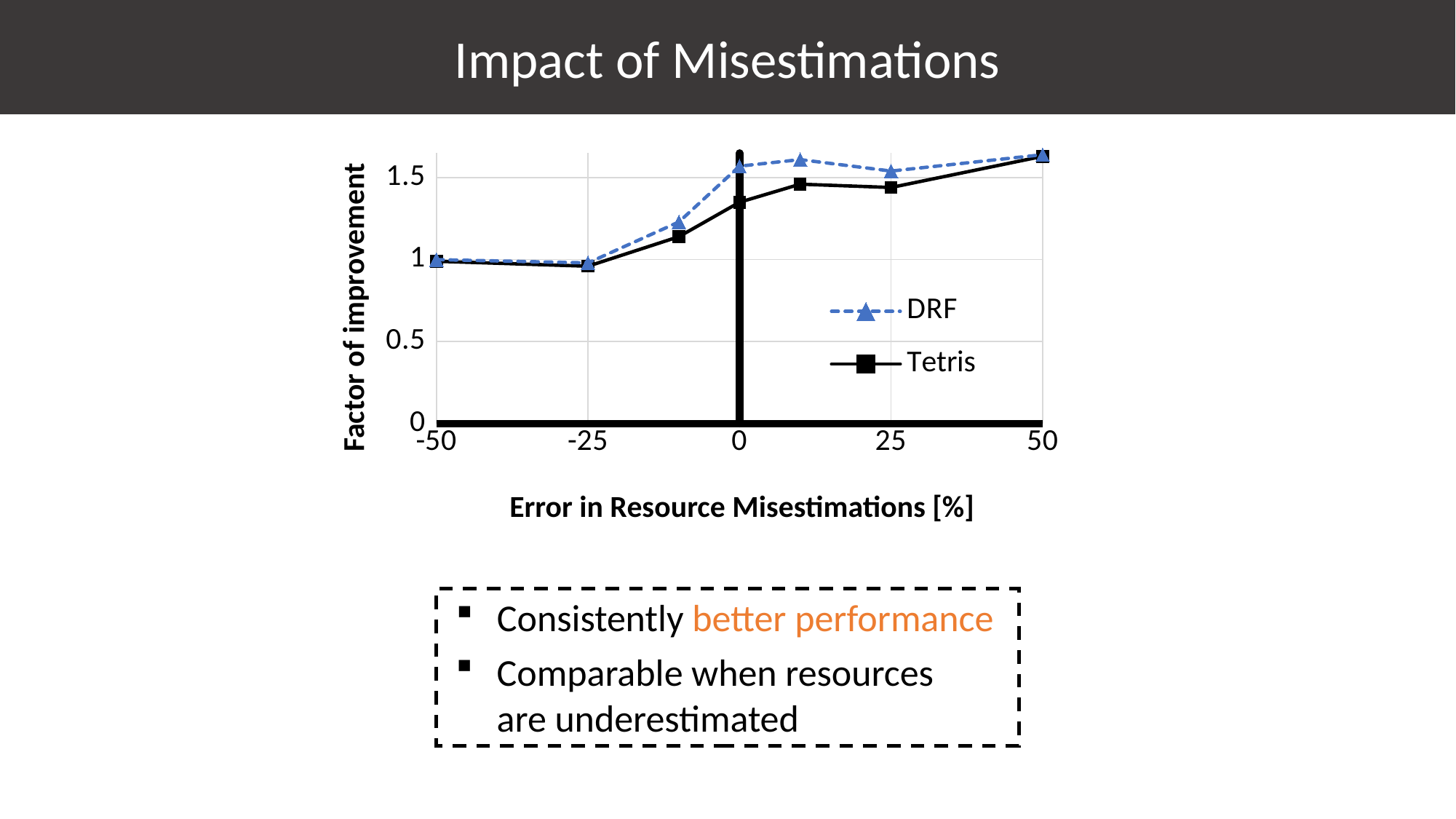
Is the value for DRF at an error of 10% greater or less than 1.5? greater How many data points are plotted for the Tetris series? 7 Between an error of -25% and 0%, does the Tetris series rise or fall? rise Which two series are listed in the legend? DRF and Tetris Is the value for Tetris at an error of 0% greater or less than 1.5? less How many series does the legend list? 2 At which error value does the Tetris series reach its highest factor of improvement? 50 At an error of 0%, which series has the larger factor of improvement, DRF or Tetris? DRF What is the title of the x axis? Error in Resource Misestimations [%] Is the value for Tetris at an error of 50% greater or less than 1.5? greater What kind of chart is shown on the slide? line chart